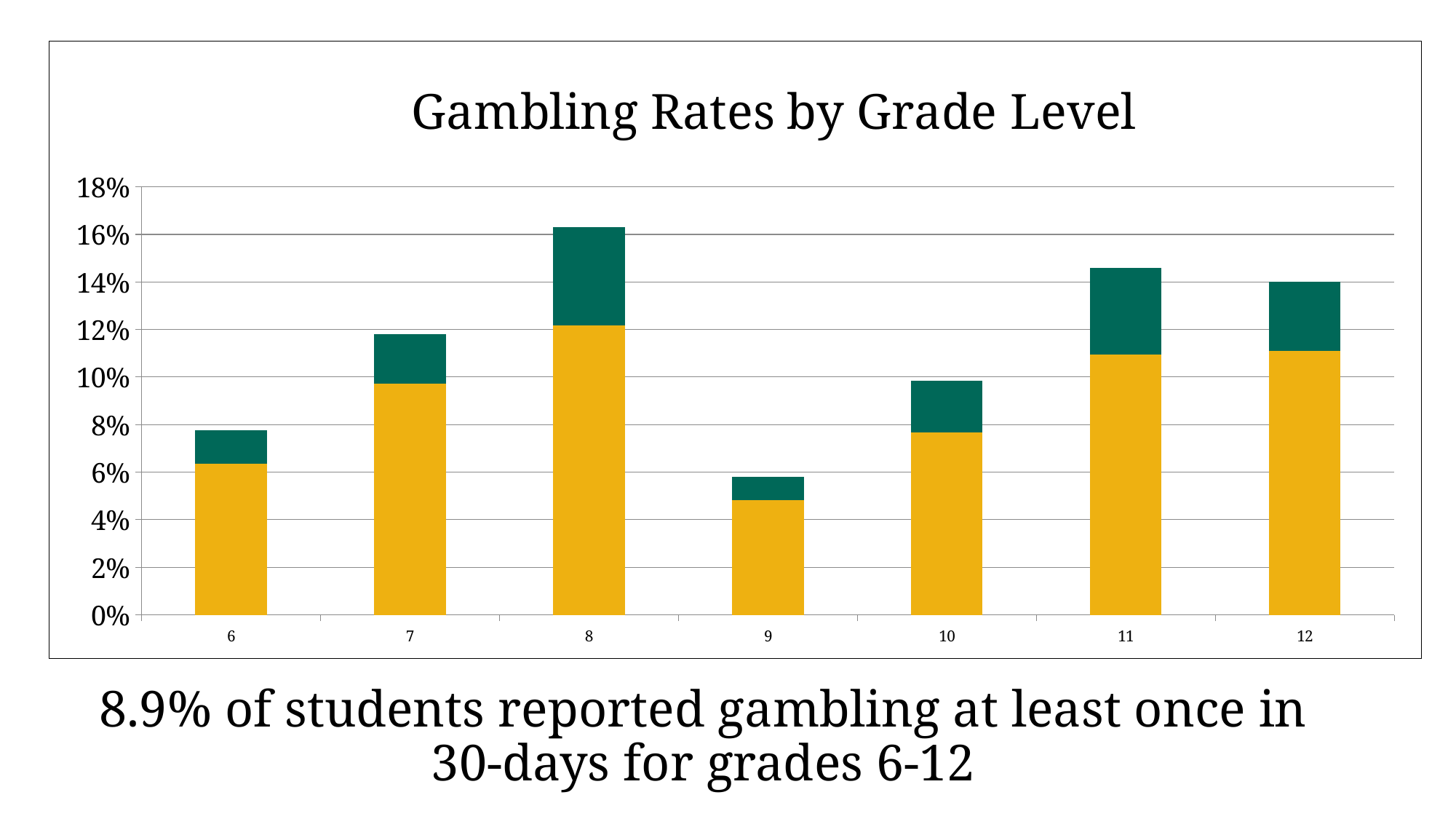
Which bar is taller, grade 6 or grade 9? grade 6 Is the total bar height for grade 10 greater or less than 12%? less Is the total bar height for grade 8 greater or less than 14%? greater What kind of chart is shown on the slide? stacked bar chart Which bar is taller, grade 8 or grade 11? grade 8 Is the total bar height for grade 7 greater or less than 10%? greater Which grade level has the shortest bar in the chart? 9 Which grade level has the tallest bar in the chart? 8 How many grade levels are shown on the x axis of the chart? 7 What is the title of the chart? Gambling Rates by Grade Level